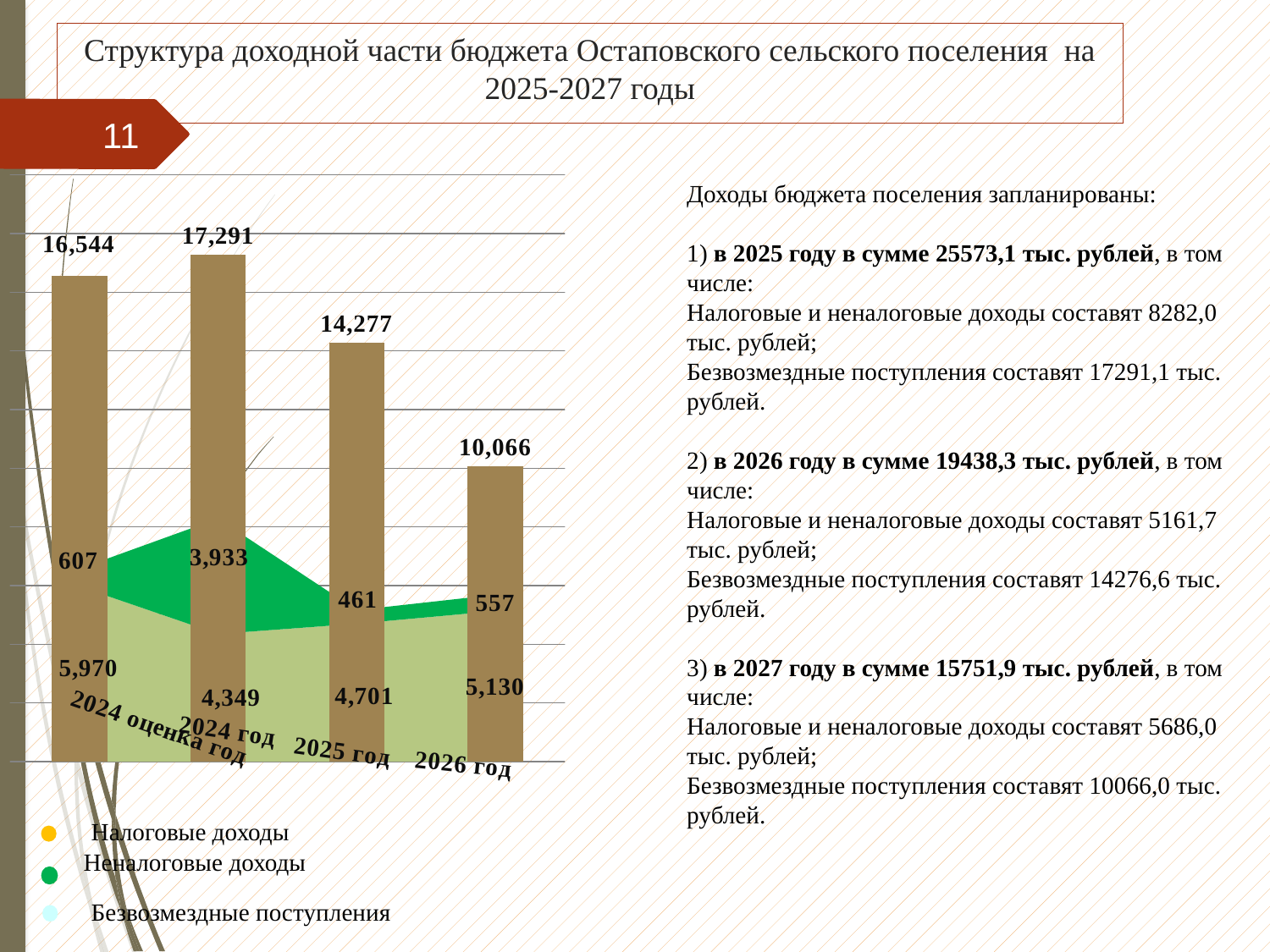
What is the value of Налоговые доходы for 2026 год? 5,130 What is the difference between Безвозмездные поступления for 2024 год and 2025 год? 3,014 What is the difference between Налоговые доходы for 2024 оценка год and 2024 год? 1,621 Which is larger: Налоговые доходы for 2024 оценка год or for 2025 год? 2024 оценка год How many series does the legend list? 3 How many categories are shown on the x axis of the chart? 4 Which category has the lowest value of Безвозмездные поступления? 2026 год What is the value of Неналоговые доходы for 2024 год? 3,933 Which category has the highest value of Неналоговые доходы? 2024 год Which category has the highest value of Безвозмездные поступления? 2024 год What is the value of Безвозмездные поступления for 2025 год? 14,277 Do the values of Безвозмездные поступления rise or fall from 2024 год to 2026 год? fall